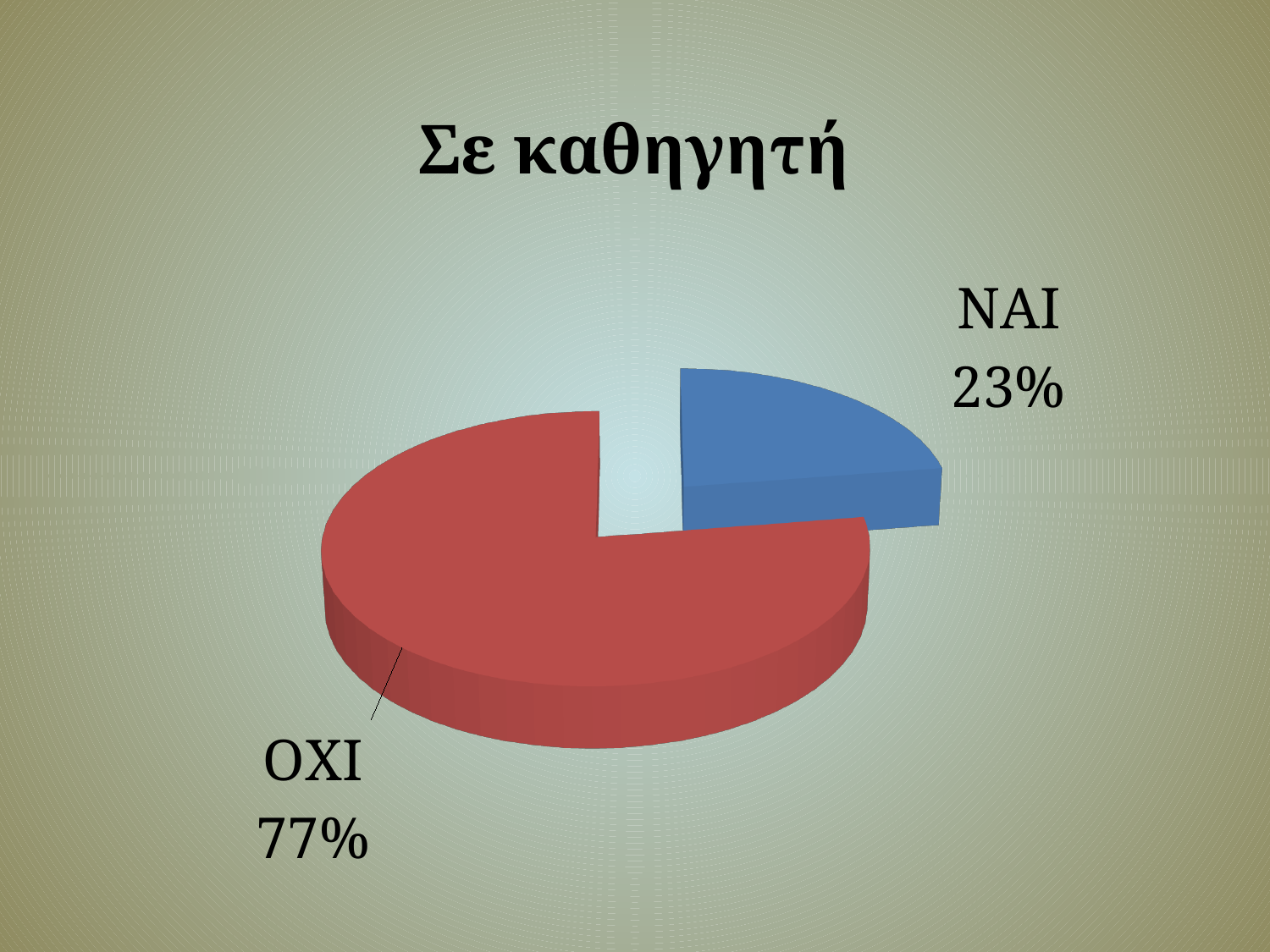
What is the difference in percentage points between ΟΧΙ and ΝΑΙ? 54 What is the title of the chart? Σε καθηγητή What colour is the ΝΑΙ slice? blue What share of the pie does ΝΑΙ represent? 23% Which is larger, ΝΑΙ or ΟΧΙ? ΟΧΙ What share of the pie does ΟΧΙ represent? 77% What is the total of the two slices' percentages? 100% What kind of chart is shown on the slide? pie chart How many slices does the pie chart have? 2 Which slice is the smallest? ΝΑΙ Which slice is the largest? ΟΧΙ